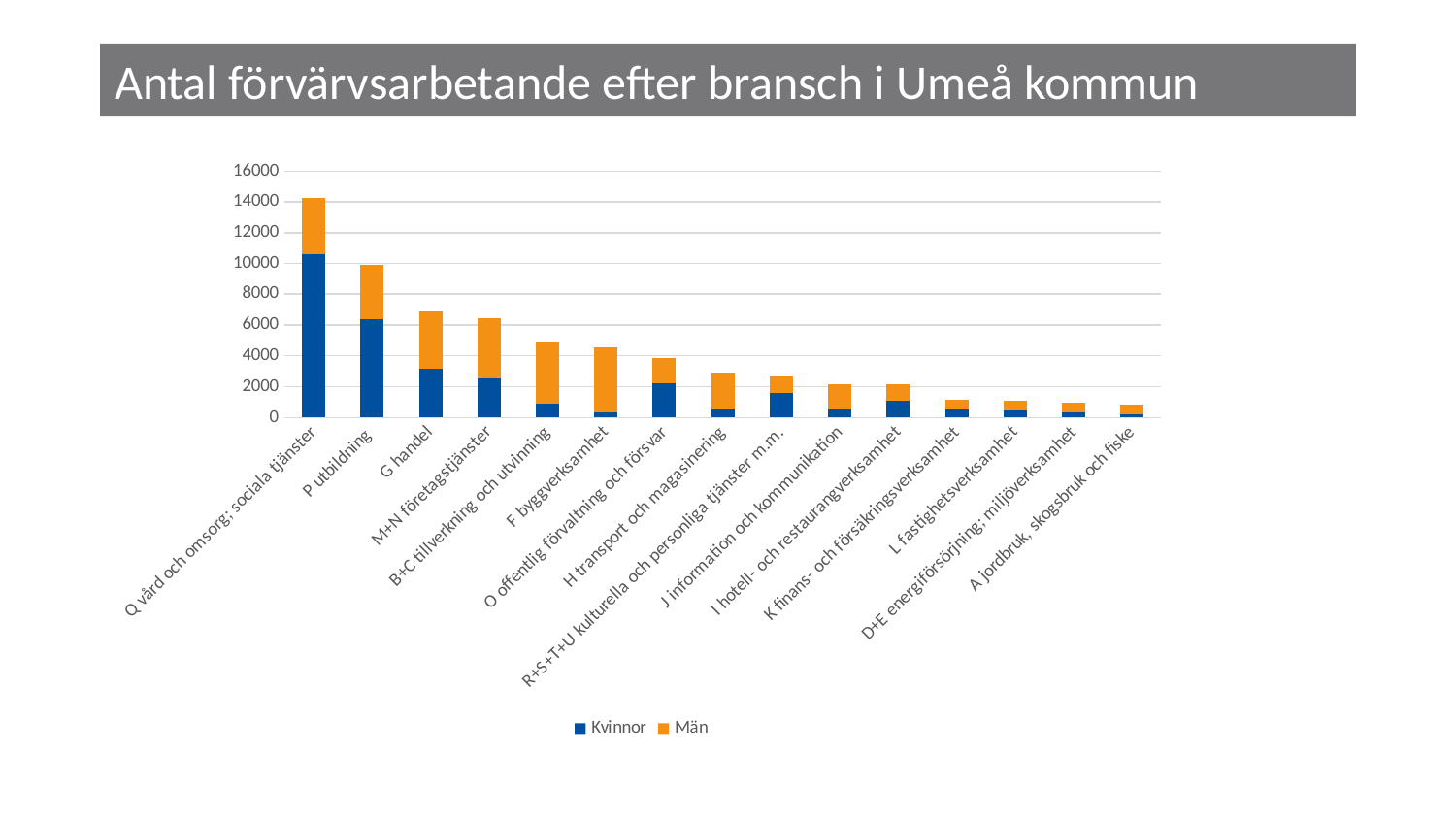
Do the total bar heights rise or fall from left to right along the x axis? Fall Is the Kvinnor value for G handel greater or less than 4000? less How many series does the legend list? 2 Which category has the tallest total bar? Q vård och omsorg; sociala tjänster How many industry categories are shown on the x axis? 15 Which is larger for F byggverksamhet, the Kvinnor segment or the Män segment? Män Which colour represents the Män series in the legend? Orange What kind of chart is shown on the slide? Stacked bar chart Which category has the shortest total bar? A jordbruk, skogsbruk och fiske What is the title of the chart? Antal förvärvsarbetande efter bransch i Umeå kommun